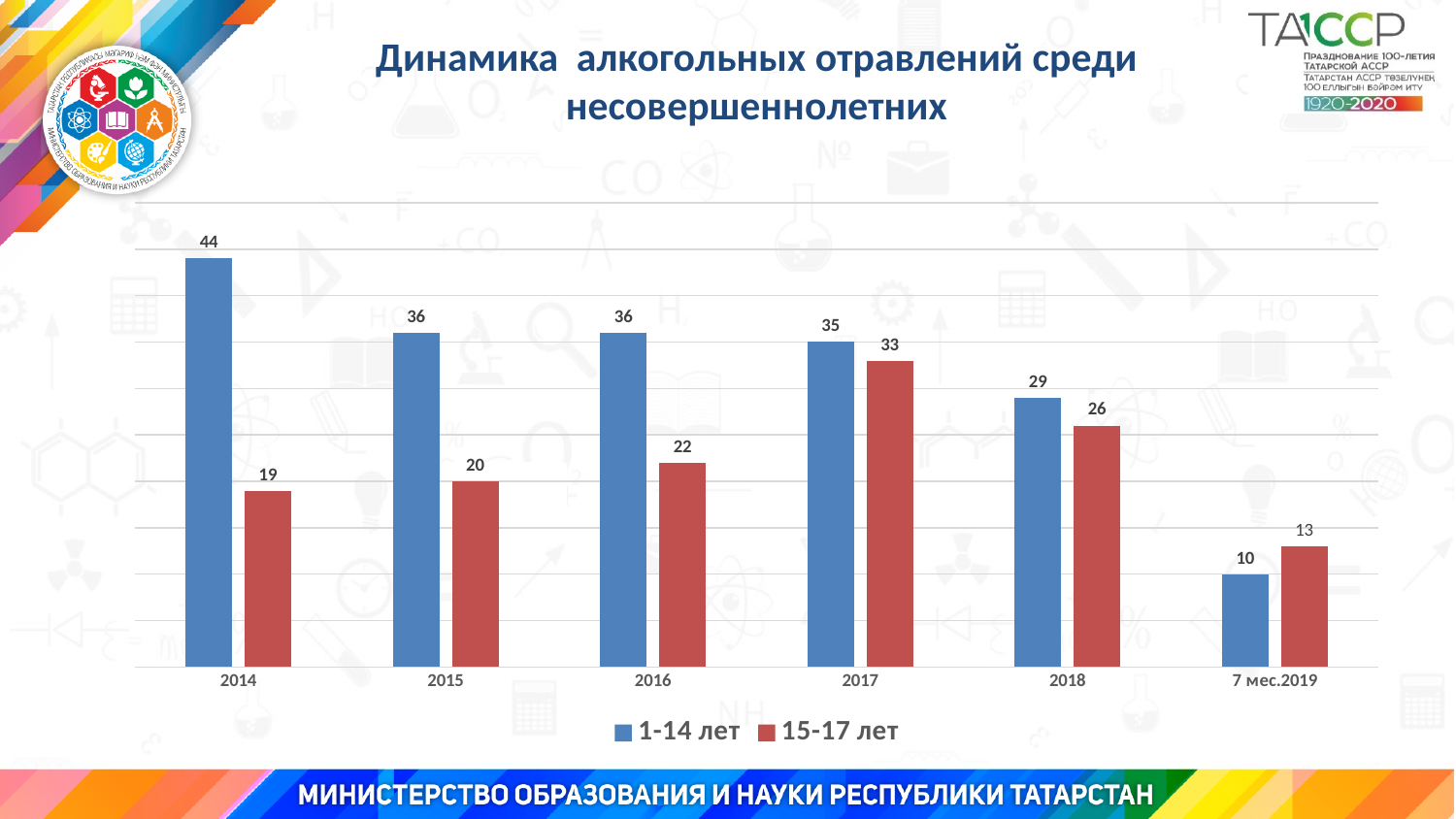
In 2018, which series has the larger value, 1-14 лет or 15-17 лет? 1-14 лет What kind of chart is shown on the slide? bar chart What is the difference between the 1-14 лет and 15-17 лет values in 2014? 25 What is the title of the chart? Динамика алкогольных отравлений среди несовершеннолетних What is the value for the 1-14 лет series in 2014? 44 Which category has the highest value for the 1-14 лет series? 2014 What is the value for the 15-17 лет series in 2017? 33 How many series does the legend list? 2 Which category has the lowest value for the 15-17 лет series? 7 мес.2019 Do the values for the 1-14 лет series rise or fall from 2014 to 7 мес.2019? fall What is the value for the 15-17 лет series in 7 мес.2019? 13 How many categories are shown on the x axis? 6